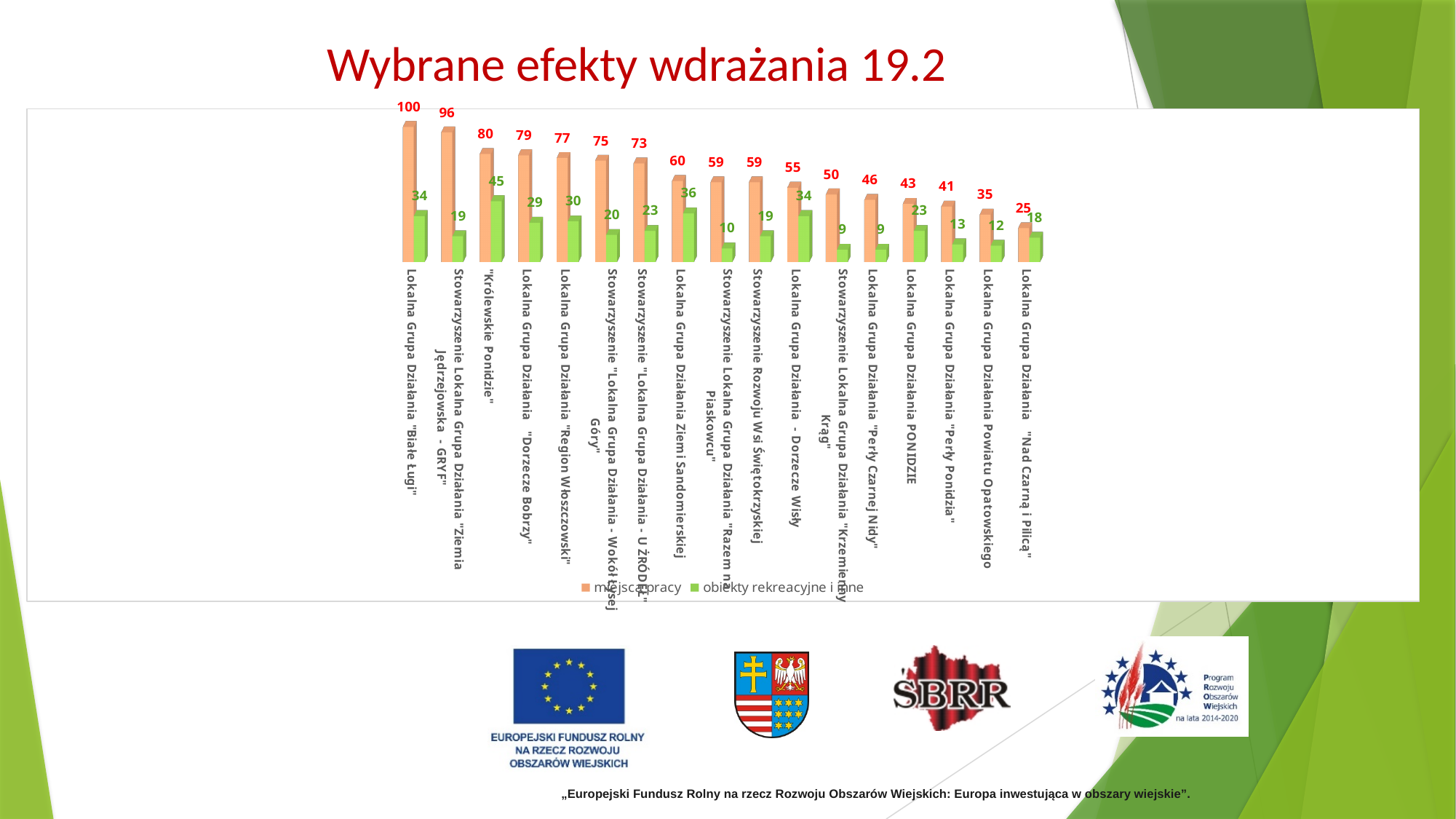
Which is larger: "obiekty rekreacyjne i inne" for Lokalna Grupa Działania "Dorzecze Bobrzy" or for Lokalna Grupa Działania "Region Włoszczowski"? Lokalna Grupa Działania "Region Włoszczowski" What kind of chart is shown on the slide? bar chart Which category has the highest value for "miejsca pracy"? Lokalna Grupa Działania "Białe Ługi" What is the title of the slide above the chart? Wybrane efekty wdrażania 19.2 What is the difference between "miejsca pracy" and "obiekty rekreacyjne i inne" for Lokalna Grupa Działania PONIDZIE? 20 How many categories are shown on the x axis of the chart? 17 Which category has the lowest value for "miejsca pracy"? Lokalna Grupa Działania "Nad Czarną i Pilicą" Which category has the highest value for "obiekty rekreacyjne i inne"? "Królewskie Ponidzie" How many series does the legend list? 2 What is the value of "obiekty rekreacyjne i inne" for "Królewskie Ponidzie"? 45 What is the value of "miejsca pracy" for Lokalna Grupa Działania "Białe Ługi"? 100 What is the value of "miejsca pracy" for Lokalna Grupa Działania Ziemi Sandomierskiej? 60